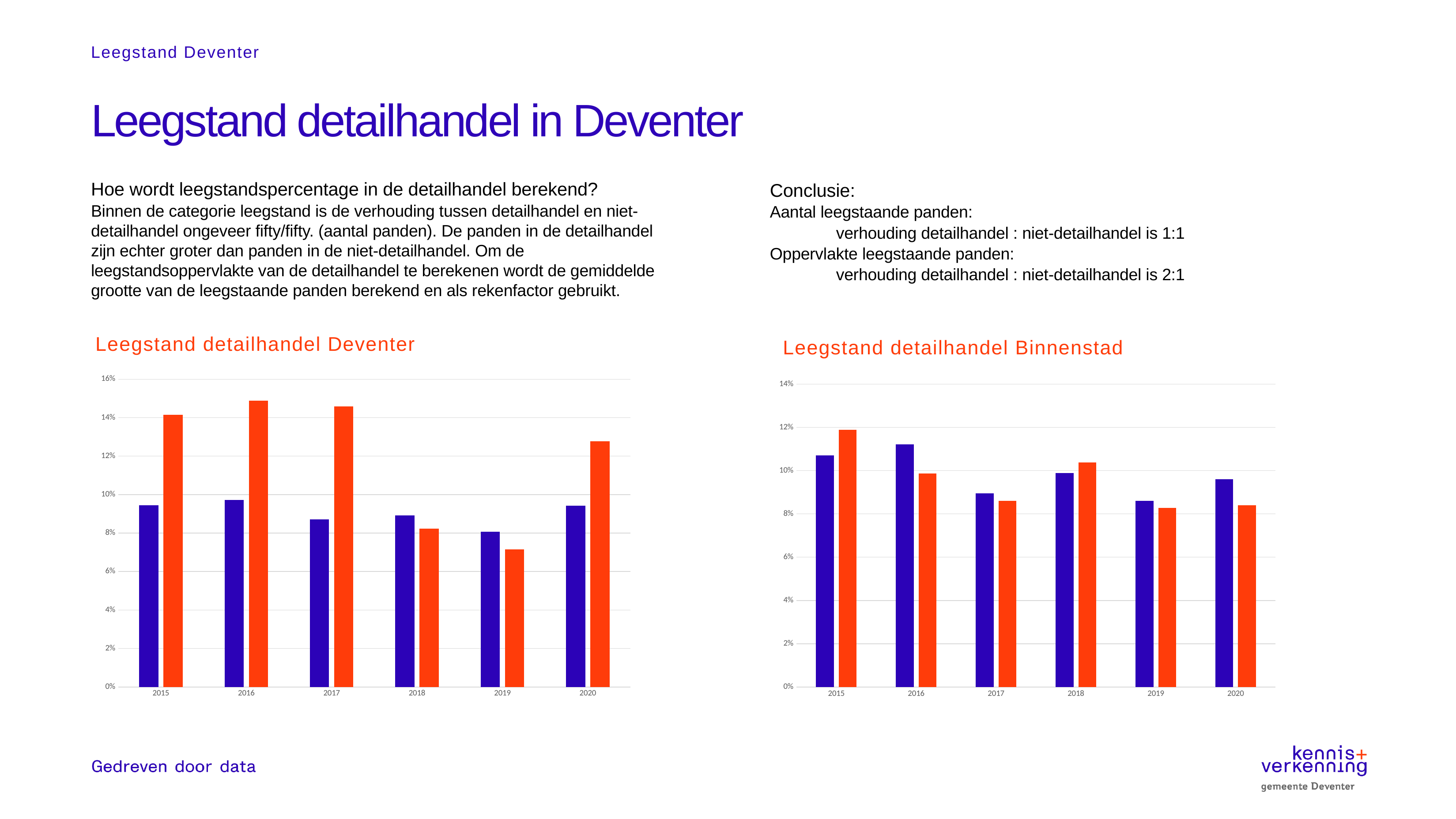
In the chart titled "Leegstand detailhandel Binnenstad", for 2016, which bar is taller, the blue one or the orange one? the blue one In the chart titled "Leegstand detailhandel Deventer", for 2018, which bar is taller, the blue one or the orange one? the blue one In the chart titled "Leegstand detailhandel Binnenstad", do the orange bars rise or fall from 2015 to 2017? fall In the chart titled "Leegstand detailhandel Deventer", how many years are shown on the x axis? 6 In the chart titled "Leegstand detailhandel Deventer", for 2015, which bar is taller, the blue one or the orange one? the orange one In the chart titled "Leegstand detailhandel Deventer", is the value of the orange bar for 2016 greater or less than 14%? greater In the chart titled "Leegstand detailhandel Deventer", is the value of the orange bar for 2019 greater or less than 8%? less In the chart titled "Leegstand detailhandel Binnenstad", how many years are shown on the x axis? 6 What is the title of the chart on the right side of the slide? Leegstand detailhandel Binnenstad In the chart titled "Leegstand detailhandel Deventer", in which year is the orange bar lowest? 2019 In the chart titled "Leegstand detailhandel Binnenstad", is the value of the blue bar for 2016 greater or less than 10%? greater In the chart titled "Leegstand detailhandel Deventer", what kind of chart is shown? bar chart